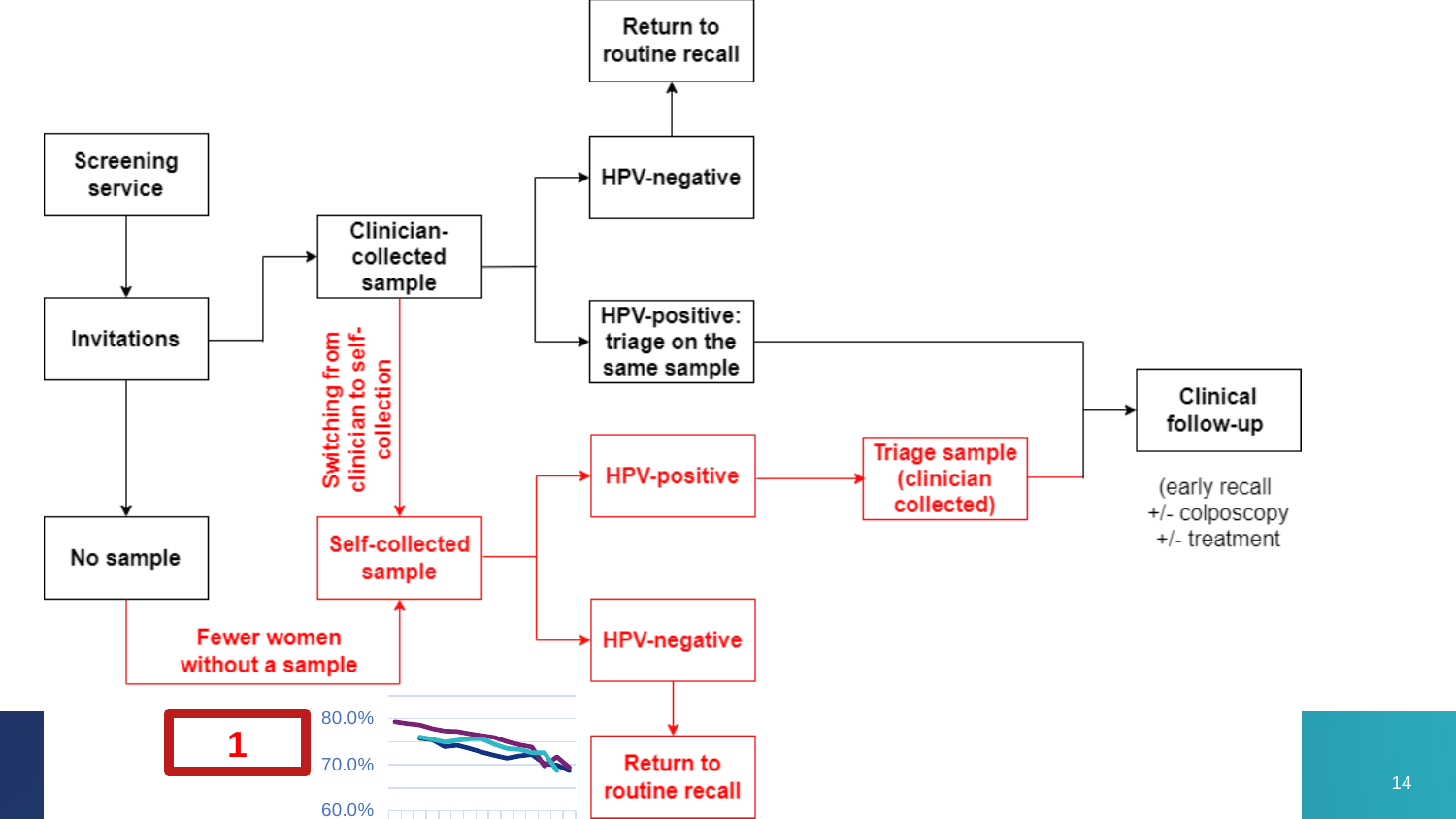
What is the highest tick label shown on the y-axis of the line chart at the bottom of the slide? 80.0% What kind of chart is shown at the bottom of the slide? line chart In the line chart at the bottom of the slide, are all the plotted values greater or less than 60.0%? greater What is the lowest tick label shown on the y-axis of the line chart at the bottom of the slide? 60.0% In the line chart at the bottom of the slide, do the values rise or fall from left to right? fall How many lines are plotted in the line chart at the bottom of the slide? 3 In the line chart at the bottom of the slide, is the starting value of the purple line greater or less than 70.0%? greater